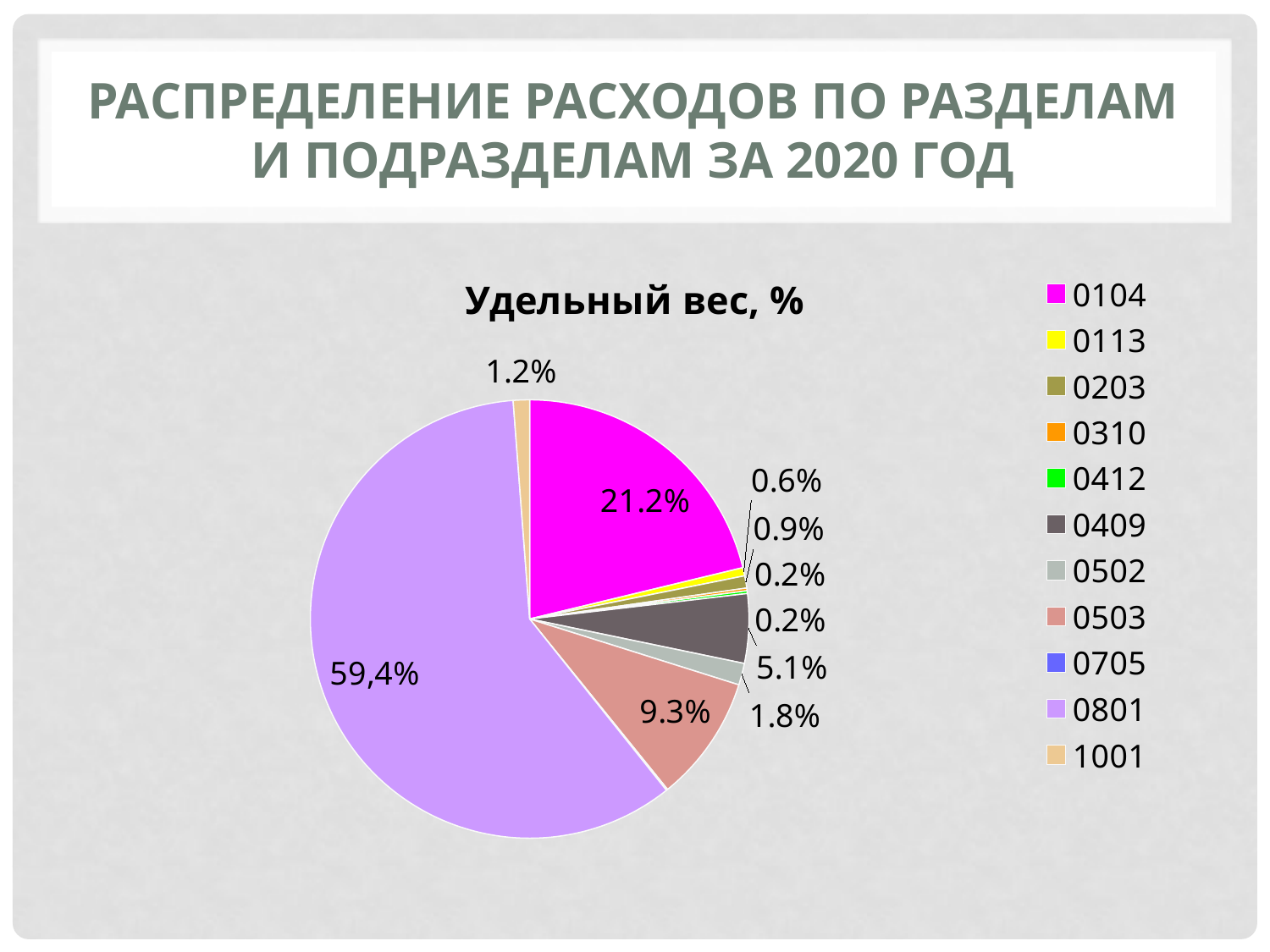
What share of the pie does category 0409 have? 5.1% What kind of chart is shown on the slide? pie chart Which is larger, the slice for 0104 or the slice for 0503? 0104 Which category has the largest slice of the pie? 0801 What share of the pie does category 0801 have? 59,4% What colour is the slice for category 0104? magenta What is the difference between the shares of 0801 and 0104? 38.2% How many entries does the chart legend list? 11 What share of the pie does category 0503 have? 9.3% What is the title of the chart? Удельный вес, %